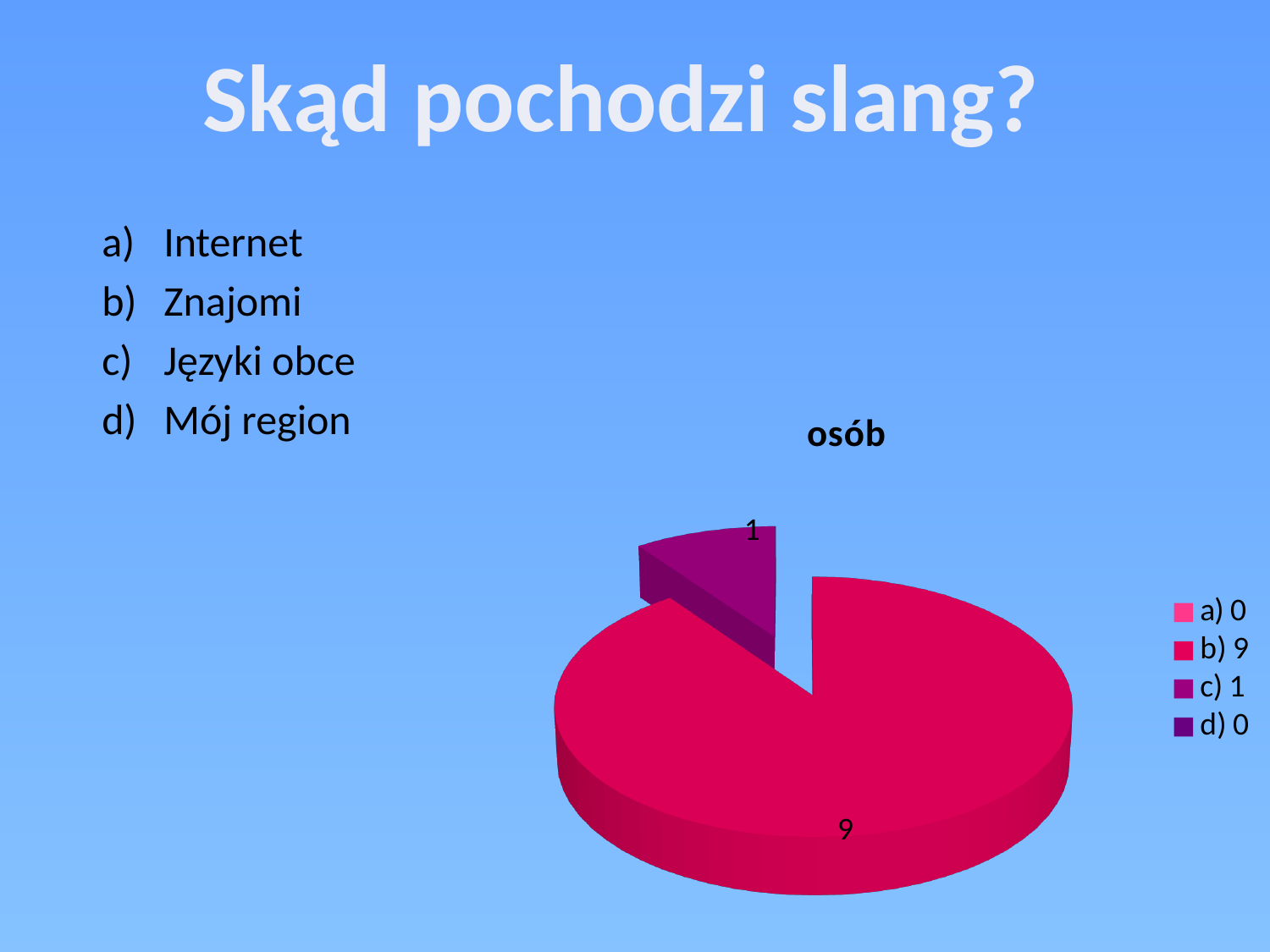
What is the value for a) in the chart? 0 Which category has the largest slice of the pie? b) What is the value for c) in the chart? 1 What is the difference between the values for b) and c)? 8 How many entries does the chart legend list? 4 What share of the pie does slice b) represent? 90% What is the value for b) in the chart? 9 What is the value for d) in the chart? 0 What is the title of the chart? osób Which is larger, the value for b) or the value for c)? b) What kind of chart is shown on the slide? pie chart What is the total of all values shown in the chart legend? 10